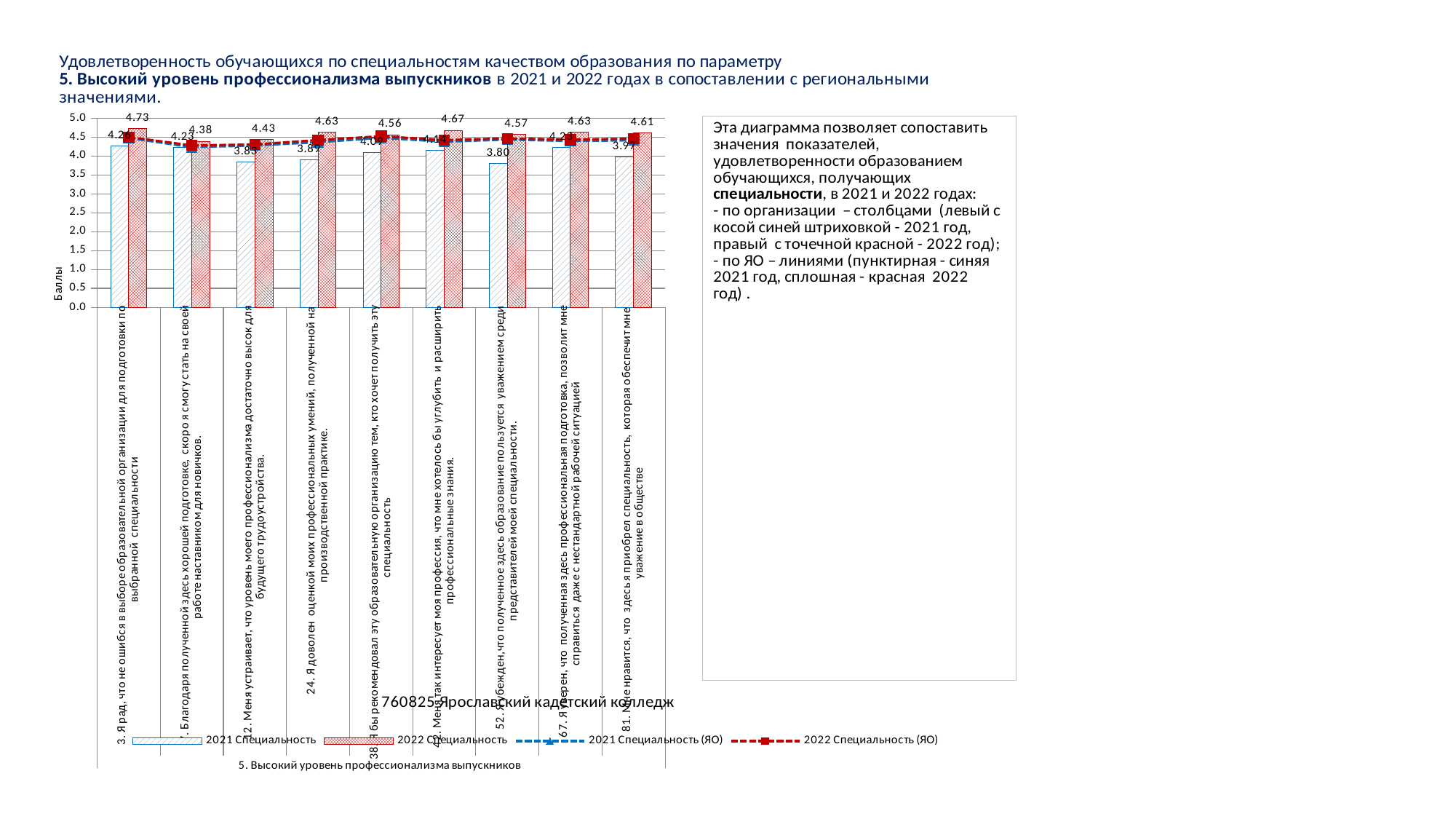
What is the title of the vertical axis? Баллы What is the 2022 Специальность value for the statement "81. Мне нравится, что здесь я приобрел специальность, которая обеспечит мне уважение в обществе"? 4.61 How many statements (categories) are shown on the x axis? 9 What is the 2022 Специальность value for the statement "24. Я доволен оценкой моих профессиональных умений, полученной на производственной практике"? 4.63 How many series does the legend list? 4 What is the difference between the 2022 and 2021 Специальность values for the statement "24. Я доволен оценкой моих профессиональных умений, полученной на производственной практике"? 0.74 What kind of chart is used for the organisation's values? Bar chart What is the 2021 Специальность value for the statement "12. Меня устраивает, что уровень моего профессионализма достаточно высок для будущего трудоустройства"? 3.83 Which statement has the highest 2022 Специальность value? 3. Я рад, что не ошибся в выборе образовательной организации для подготовки по выбранной специальности What is the 2022 Специальность value for the statement "3. Я рад, что не ошибся в выборе образовательной организации для подготовки по выбранной специальности"? 4.73 Which statement has the lowest 2021 Специальность value? 52. Убежден, что полученное здесь образование пользуется уважением среди представителей моей специальности